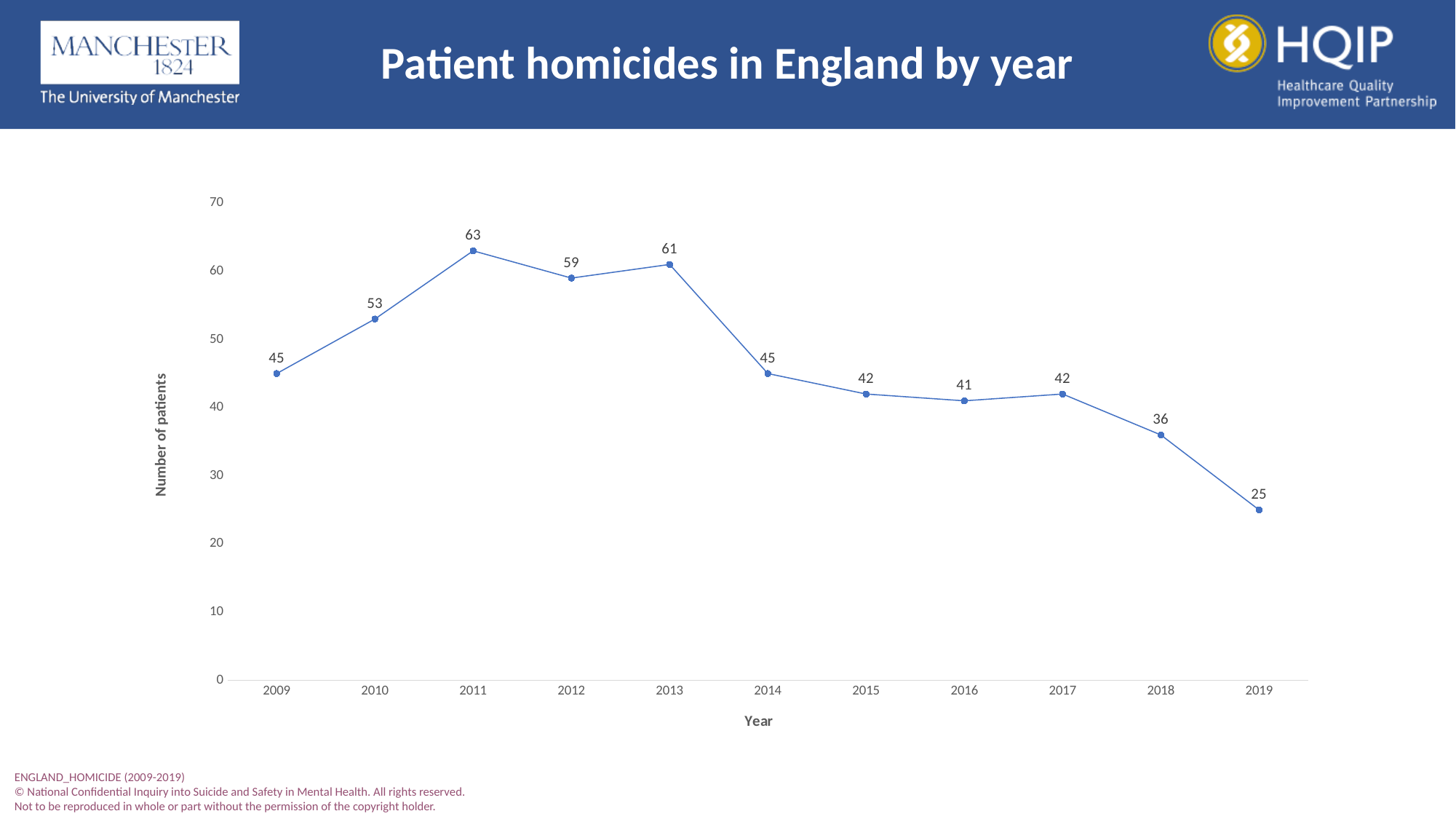
What kind of chart is shown on the slide? Line chart What is the number of patients in 2019? 25 What is the number of patients in 2011? 63 What is the label of the y axis? Number of patients What is the number of patients in 2016? 41 Which year has more patients, 2010 or 2018? 2010 Which year has the lowest number of patients? 2019 What is the difference in the number of patients between 2013 and 2014? 16 Which year has the highest number of patients? 2011 How many years are plotted on the chart? 11 Is the value for 2012 greater or less than 50? greater What is the difference in the number of patients between 2011 and 2019? 38